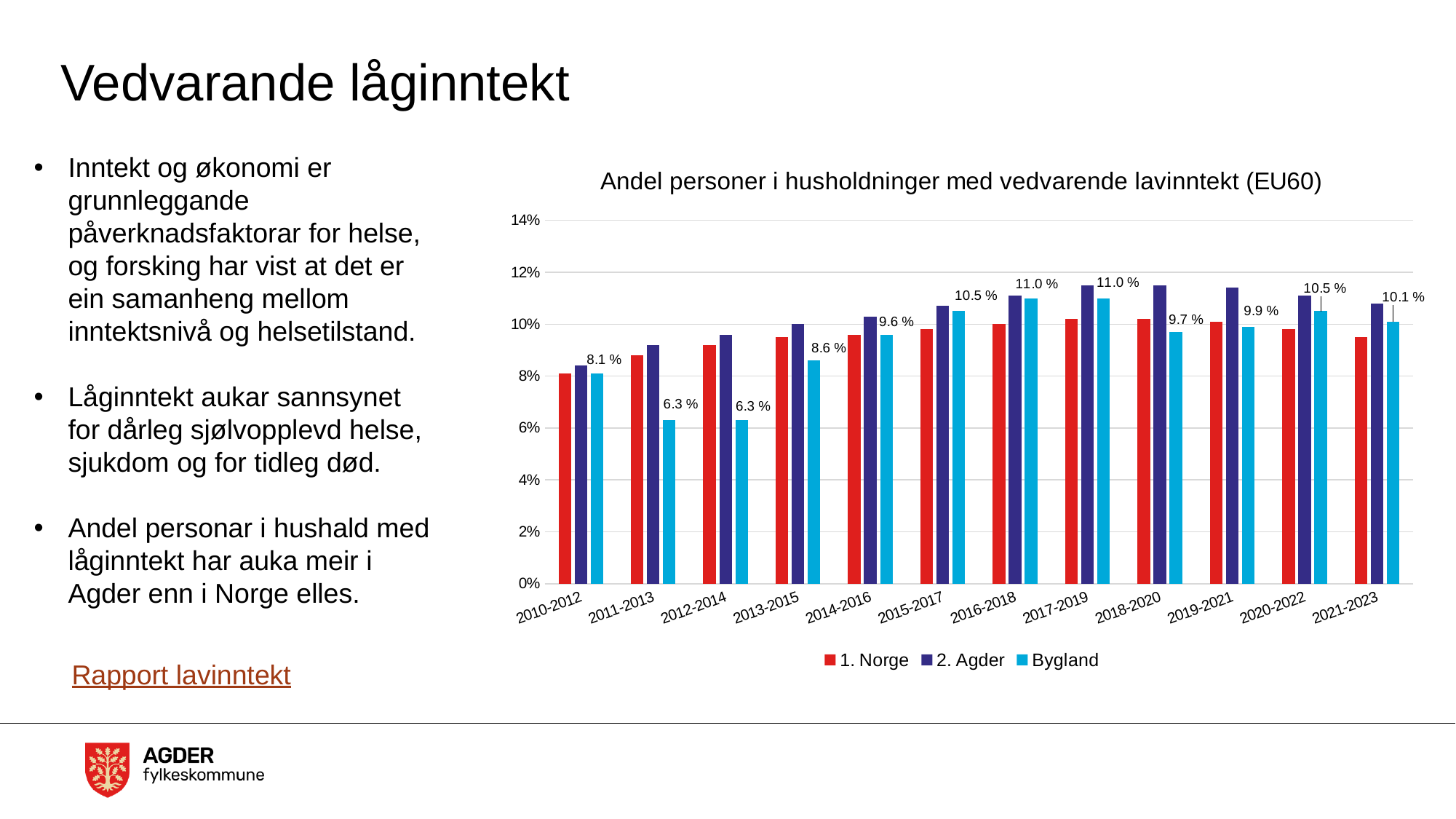
How many time periods are shown on the x axis? 12 What is the lowest value shown for Bygland? 6.3 % What is the value for Bygland in 2018-2020? 9.7 % What is the value for Bygland in 2021-2023? 10.1 % Is the value for 2. Agder in 2017-2019 greater or less than 10%? greater Which period has the larger Bygland value, 2013-2015 or 2014-2016? 2014-2016 How many series does the legend list? 3 Is the value for 1. Norge in 2010-2012 greater or less than 10%? less What is the difference between the Bygland values for 2015-2017 and 2010-2012? 2.4 percentage points What kind of chart is shown on the slide? Bar chart What is the highest value shown for Bygland? 11.0 % What is the value for Bygland in 2010-2012? 8.1 %